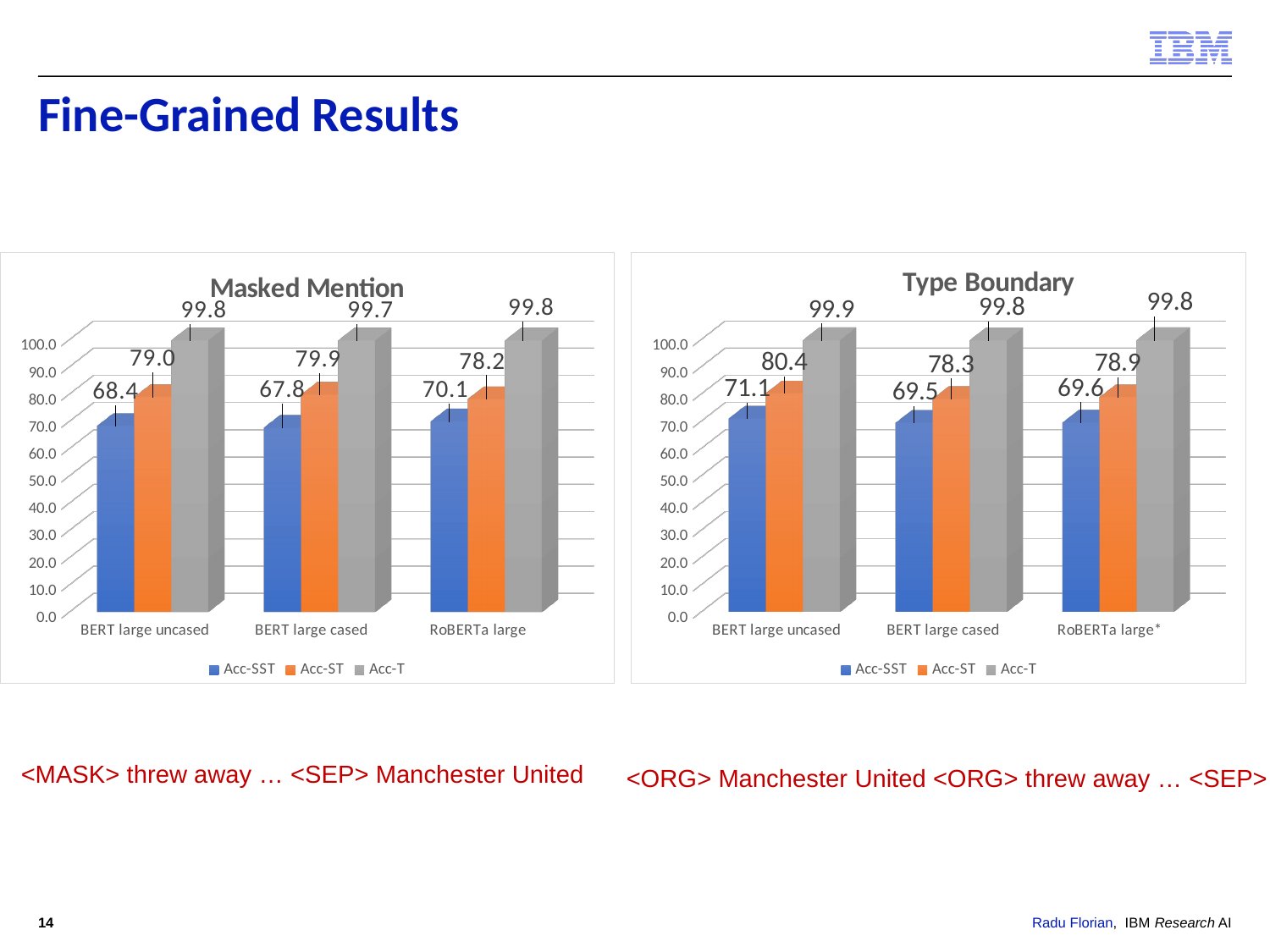
What kind of chart is the Type Boundary chart? bar chart In the Masked Mention chart, what is the Acc-ST value for BERT large cased? 79.9 In the Masked Mention chart, what is the difference between the Acc-ST and Acc-SST values for RoBERTa large? 8.1 In the Type Boundary chart, what is the Acc-ST value for BERT large uncased? 80.4 How many model categories are shown on the x axis of the Masked Mention chart? 3 In the Masked Mention chart, what is the Acc-SST value for BERT large uncased? 68.4 In the Type Boundary chart, what is the difference between the Acc-T and Acc-ST values for BERT large uncased? 19.5 In the Masked Mention chart, which model has the highest Acc-SST value? RoBERTa large In the Type Boundary chart, which model has the lowest Acc-ST value? BERT large cased In the Type Boundary chart, what is the Acc-SST value for RoBERTa large*? 69.6 In the Masked Mention chart, is the Acc-ST value for BERT large uncased greater or less than 70.0? greater How many series does the legend of the Type Boundary chart list? 3